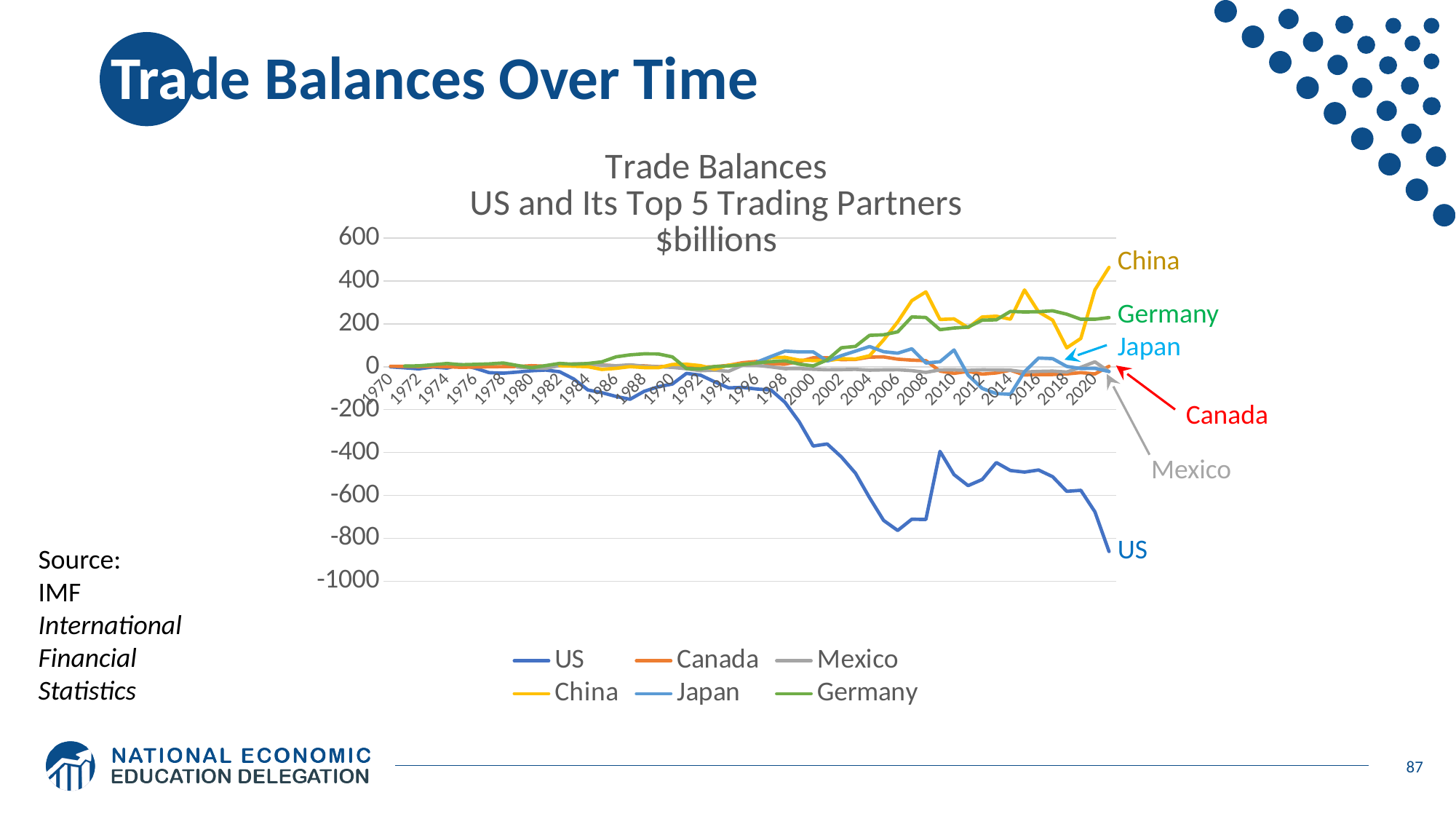
In what units are the values on the chart expressed? $billions Is the value for the US in 2020 greater or less than -800? greater Which series has the highest value in 2020? China Does the US line rise or fall between 1998 and 2006? falls Is the value for Germany in 2020 greater or less than 200? greater Is the value for the US in 2006 greater or less than -600? less How many series does the legend list? 6 What is the title of the chart? Trade Balances US and Its Top 5 Trading Partners $billions What kind of chart is shown on the slide? line chart Which series has the lowest value in 2020? US Which is larger in 2020, the value for China or the value for Germany? China